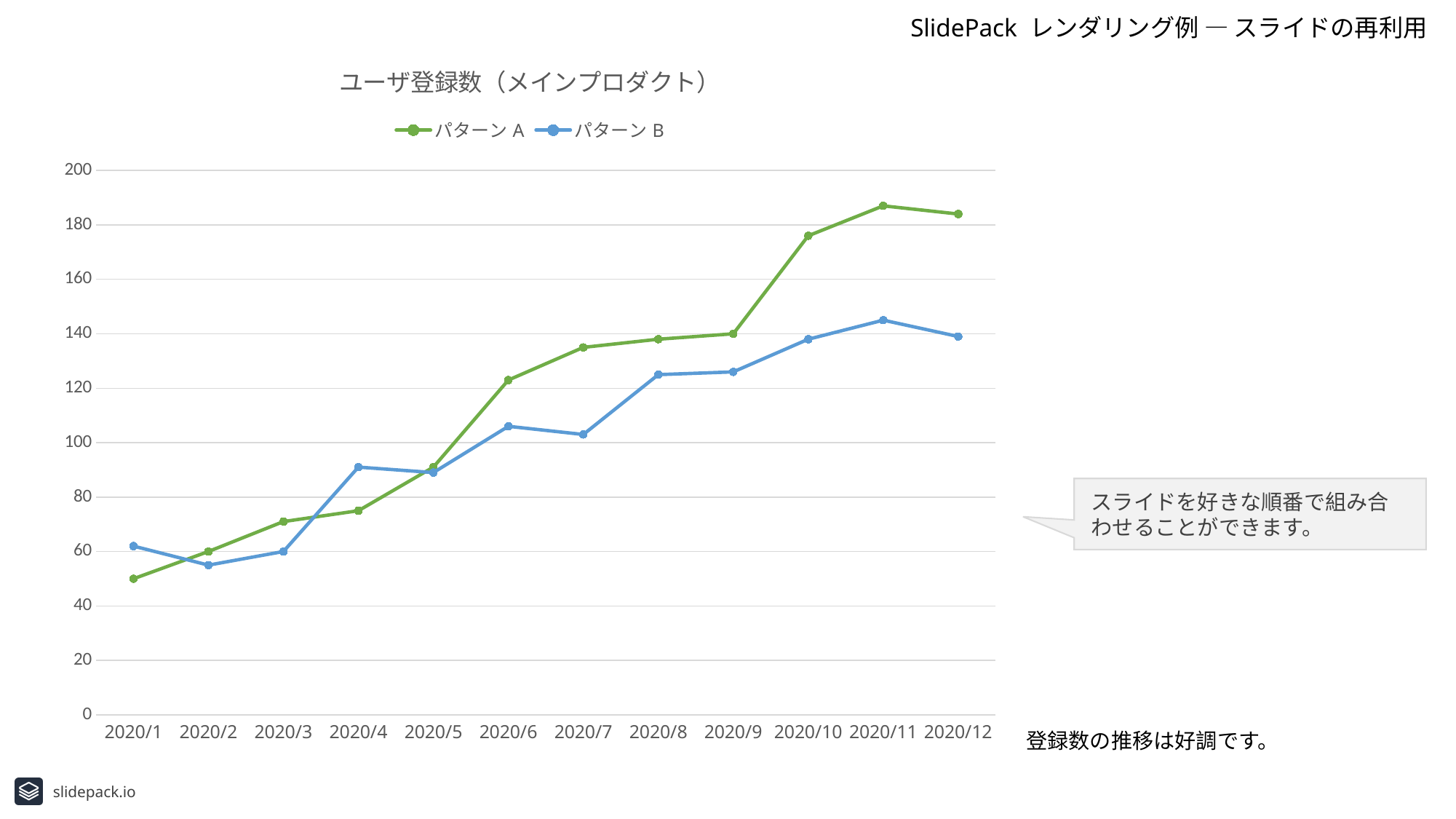
In which month is パターン B at its lowest value? 2020/2 What is the title of the chart? ユーザ登録数（メインプロダクト） In which month is パターン A at its lowest value? 2020/1 How many months are plotted along the x axis? 12 In which month does パターン B reach its highest value? 2020/11 What kind of chart is shown on the slide? line chart Is the value for パターン A at 2020/10 greater or less than 160? greater Is the value for パターン B at 2020/7 greater or less than 120? less How many series does the legend list? 2 At 2020/4, which series has the larger value, パターン A or パターン B? パターン B In which month does パターン A reach its highest value? 2020/11 At 2020/12, which series has the larger value, パターン A or パターン B? パターン A